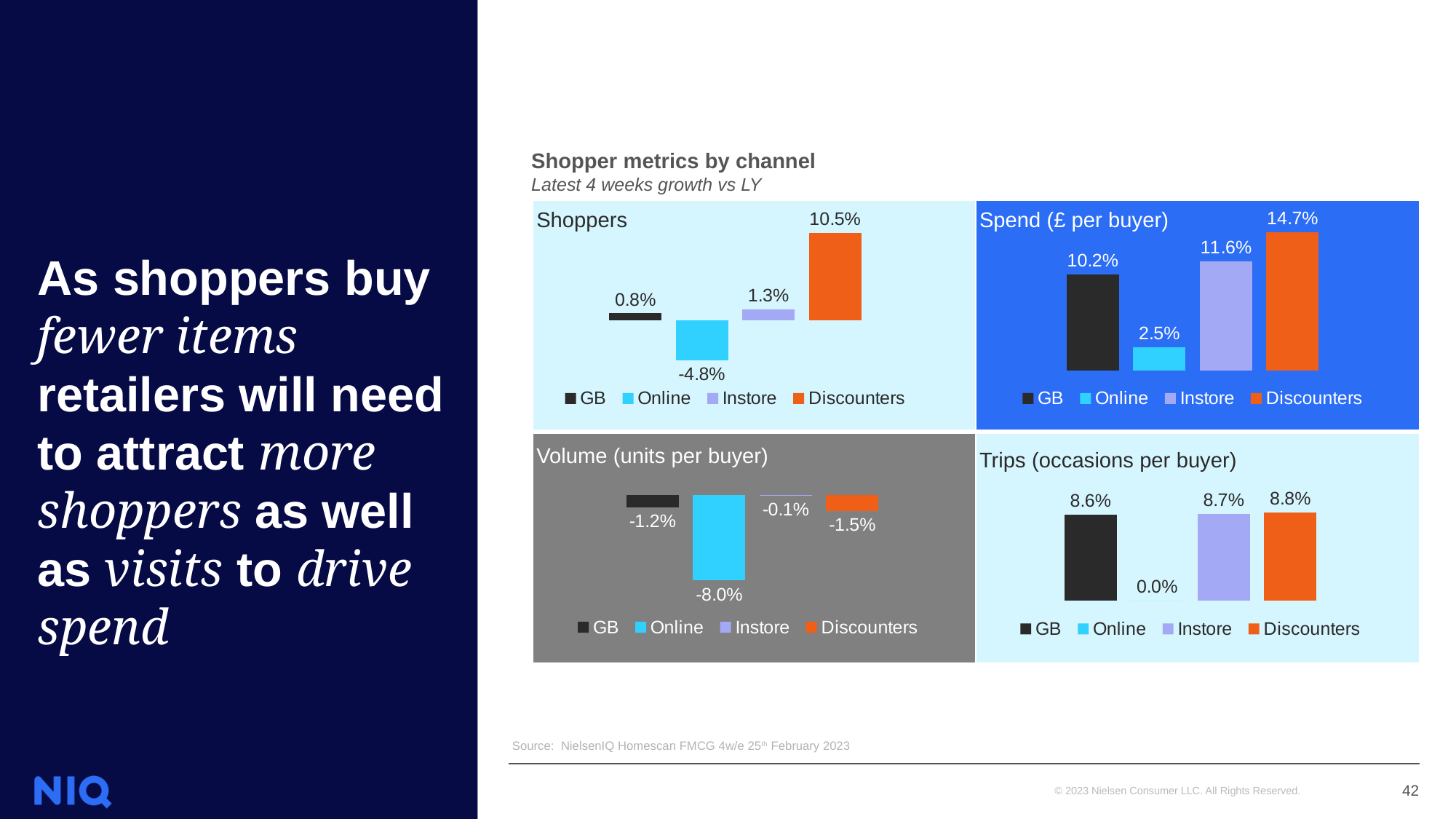
In the Shoppers chart, what is the value for Online? -4.8% In the Spend (£ per buyer) chart, what is the value for Instore? 11.6% What kind of chart is the Spend (£ per buyer) chart? Bar chart In the Spend (£ per buyer) chart, which channel has the highest value? Discounters How many series does the legend of the Shoppers chart list? 4 In the Spend (£ per buyer) chart, what is the difference between Discounters and Online? 12.2% In the Trips (occasions per buyer) chart, which is larger, the value for GB or the value for Online? GB In the Shoppers chart, what is the value for Discounters? 10.5% In the Volume (units per buyer) chart, what is the value for GB? -1.2% In the Volume (units per buyer) chart, which channel has the lowest value? Online What is the subtitle shown under the heading 'Shopper metrics by channel'? Latest 4 weeks growth vs LY In the Trips (occasions per buyer) chart, what is the value for Online? 0.0%